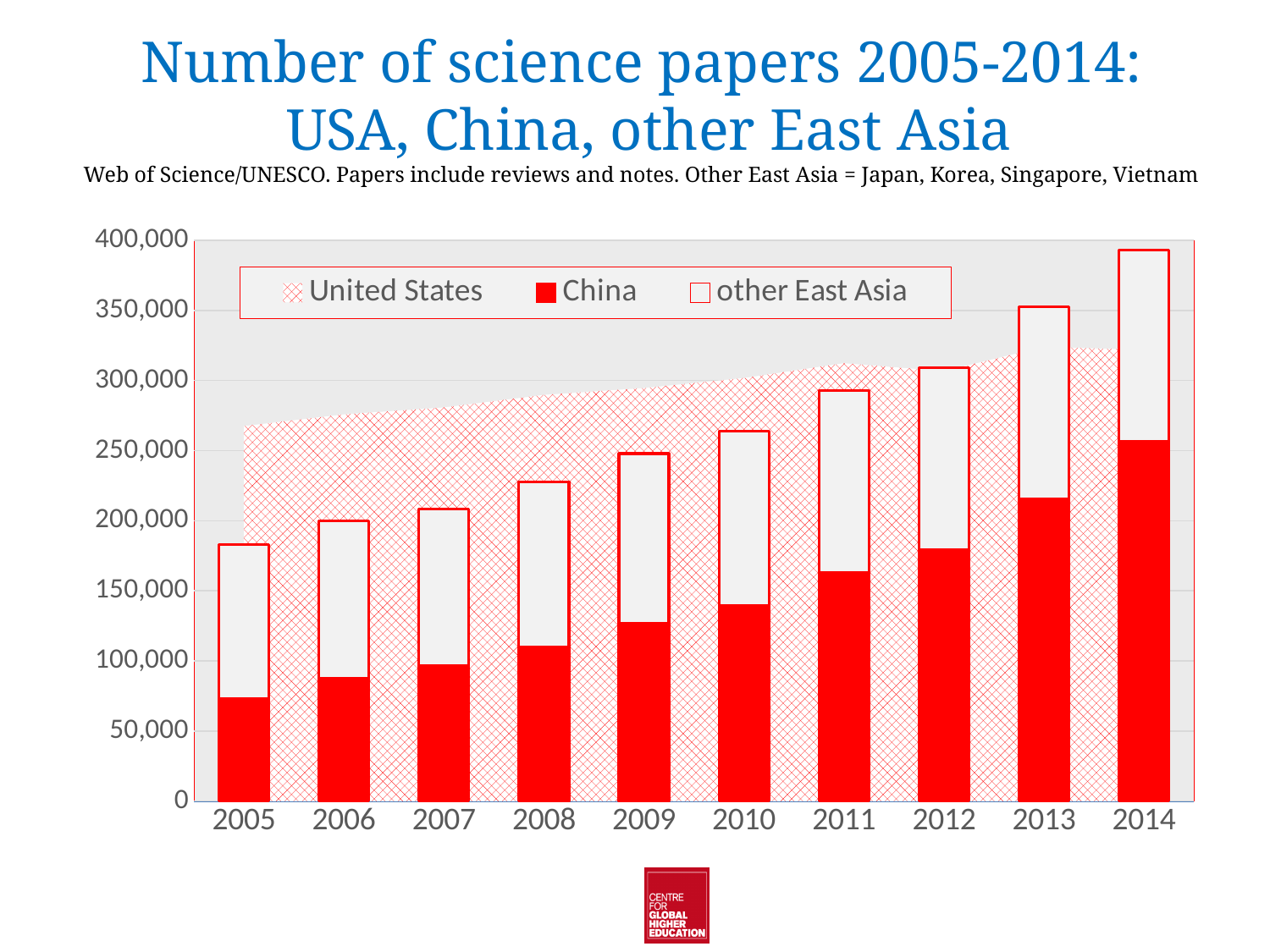
Which is larger in 2014, the China value or the United States value? United States In which year is the China value lowest? 2005 How many years are shown on the x axis? 10 How many series does the legend list? 3 What kind of chart is shown on the slide? combination of an area chart and a stacked bar chart Is the combined China plus other East Asia total for 2014 greater or less than 350,000? greater Is the China value for 2013 greater or less than 200,000? greater Do the China values rise or fall from 2005 to 2014? rise Is the China value for 2005 greater or less than 100,000? less In which year is the China value highest? 2014 Which series is shown in solid red in the legend? China